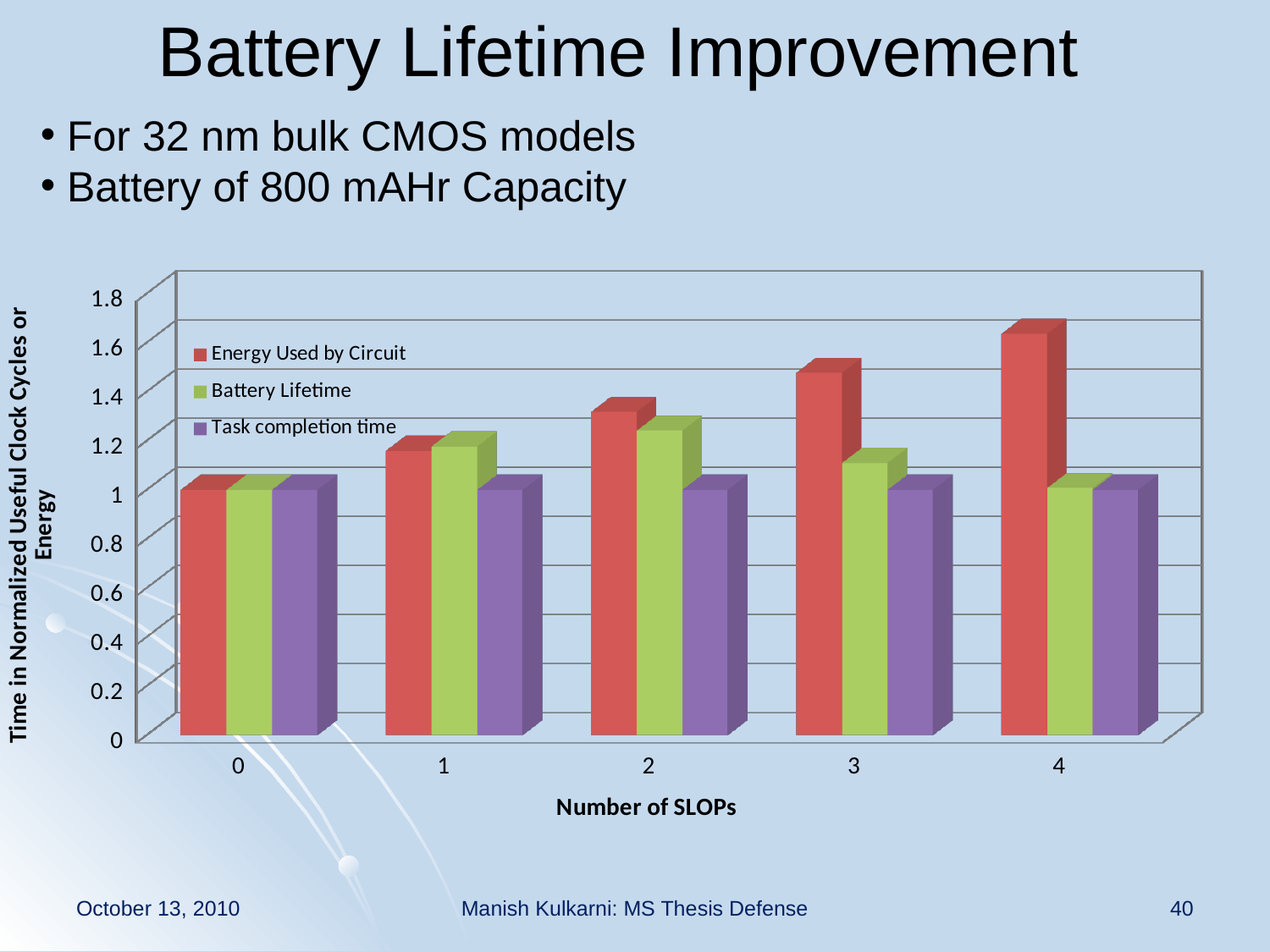
What kind of chart is shown on the slide? bar chart Is the value of Energy Used by Circuit at 3 SLOPs greater or less than 1.2? greater At 4 SLOPs, which is larger: Energy Used by Circuit or Battery Lifetime? Energy Used by Circuit Does Energy Used by Circuit rise or fall as the number of SLOPs increases from 0 to 4? rise Is the value of Battery Lifetime at 2 SLOPs greater or less than 1? greater How many categories are shown on the x axis? 5 Which series is shown in purple in the legend? Task completion time What is the title of the x axis? Number of SLOPs Is the value of Battery Lifetime at 4 SLOPs greater or less than 1.2? less How many series does the legend list? 3 For which number of SLOPs is Energy Used by Circuit highest? 4